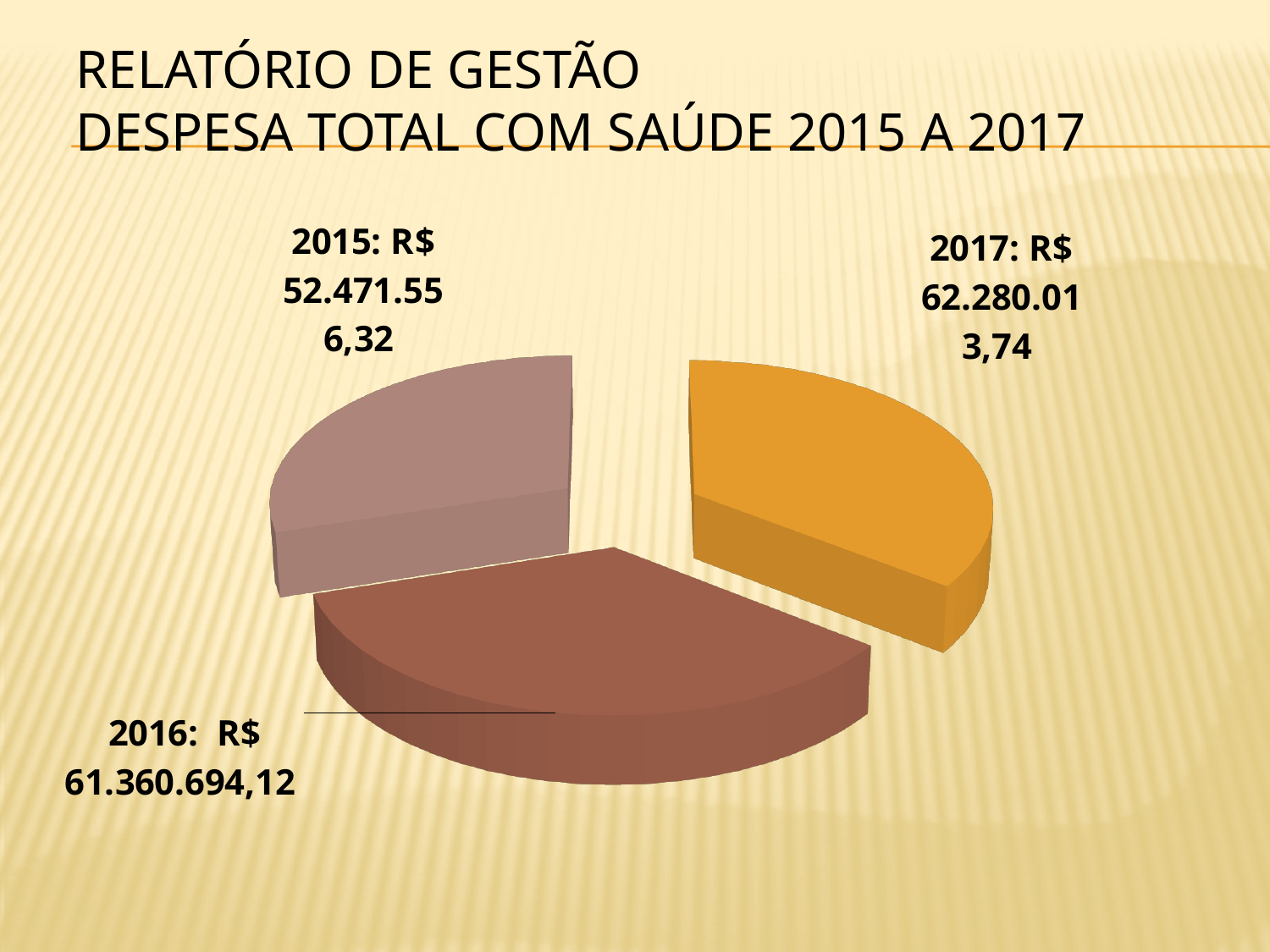
What is the combined health expenditure for 2015, 2016 and 2017? R$ 176.112.264,18 What was the total health expenditure in 2015? R$ 52.471.556,32 Do the health expenditure values rise or fall from 2015 to 2017? Rise Which year had the lowest total health expenditure? 2015 What is the difference between the 2017 and 2016 health expenditures? R$ 919.319,62 Which is larger, the health expenditure in 2015 or in 2016? 2016 What was the total health expenditure in 2016? R$ 61.360.694,12 Which year had the highest total health expenditure? 2017 What was the total health expenditure in 2017? R$ 62.280.013,74 How many years (slices) are shown in the pie chart? 3 What kind of chart is shown on the slide? Pie chart What is the difference between the 2016 and 2015 health expenditures? R$ 8.889.137,80